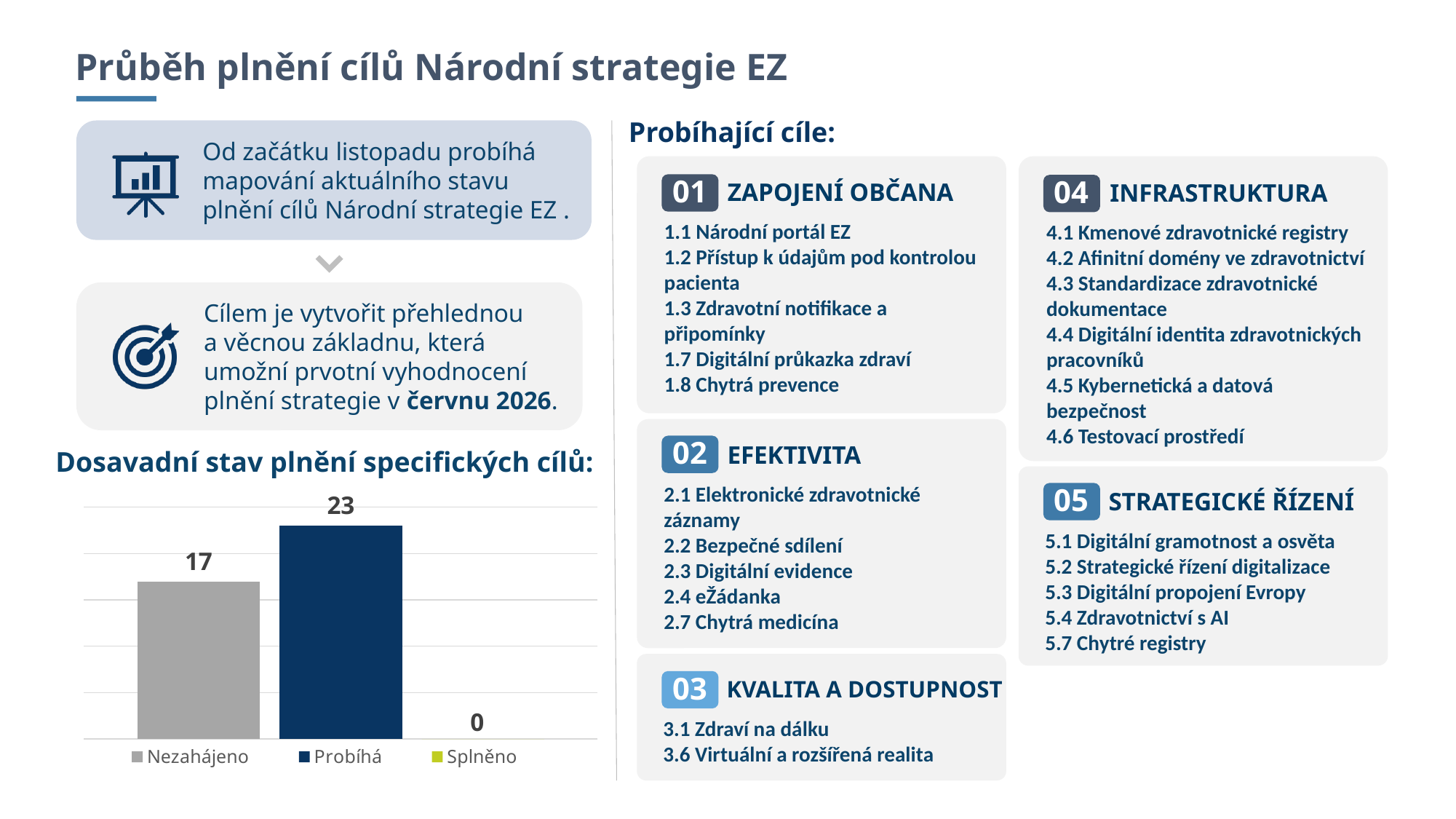
Which category has the lowest value in the bar chart? Splněno What is the value for Probíhá in the bar chart? 23 What kind of chart is shown on the slide? bar chart What is the value for Splněno in the bar chart? 0 How many categories are shown in the bar chart? 3 What is the title of the bar chart on the slide? Dosavadní stav plnění specifických cílů: What is the difference between the values for Probíhá and Nezahájeno? 6 How many entries does the legend of the bar chart list? 3 Which is larger, the value for Nezahájeno or the value for Probíhá? Probíhá What is the value for Nezahájeno in the bar chart? 17 Which category has the highest value in the bar chart? Probíhá What is the total of the three values shown in the bar chart? 40